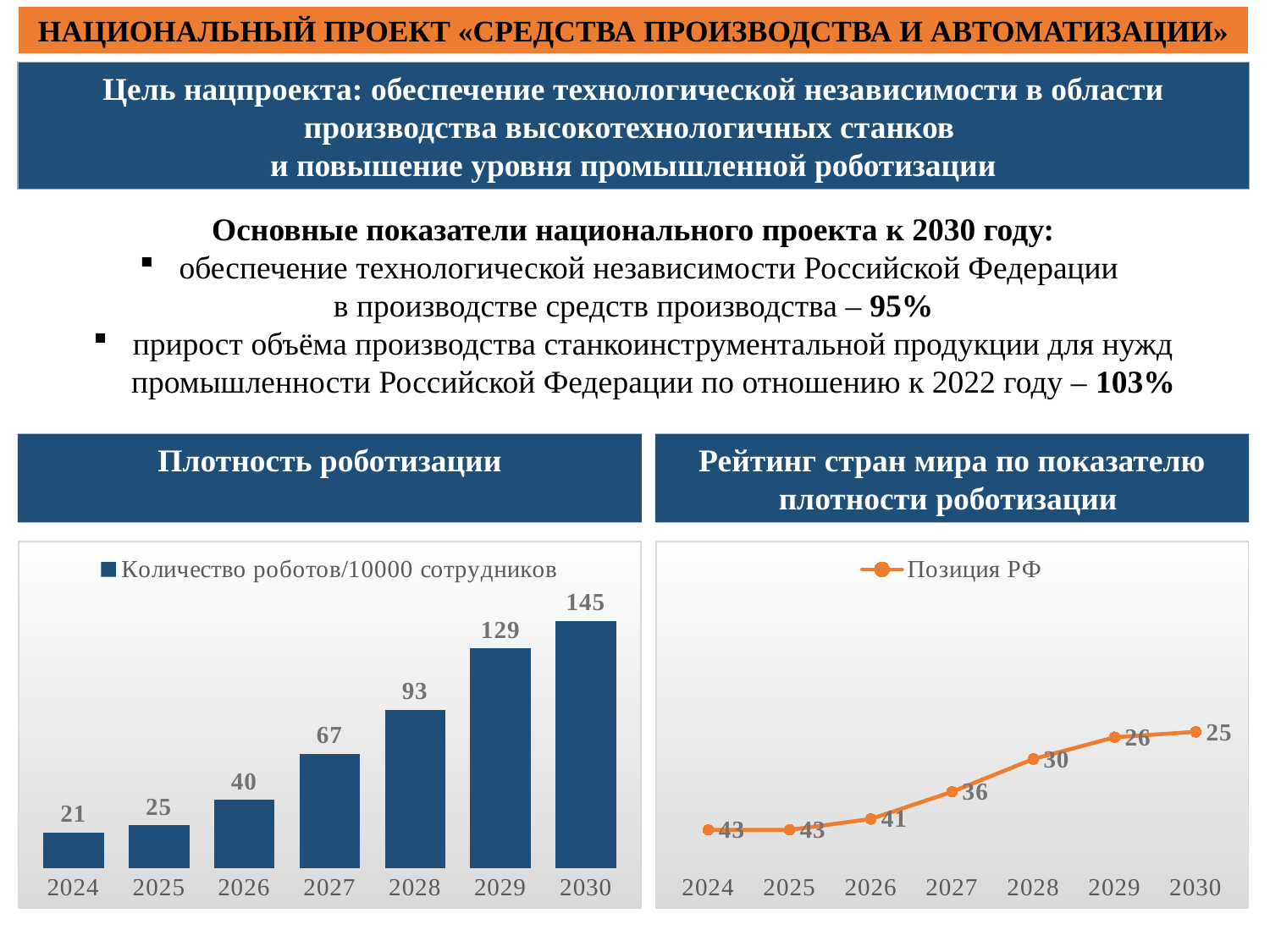
In the 'Рейтинг стран мира по показателю плотности роботизации' chart, what is the value for 2028? 30 In the 'Плотность роботизации' chart, do the values rise or fall from 2024 to 2030? rise In the 'Плотность роботизации' chart, which year has the lowest value? 2024 In the 'Рейтинг стран мира по показателю плотности роботизации' chart, is the value for 2027 larger or smaller than the value for 2029? larger What kind of chart is the 'Рейтинг стран мира по показателю плотности роботизации' chart? line chart What kind of chart is the 'Плотность роботизации' chart? bar chart What is the legend entry of the 'Рейтинг стран мира по показателю плотности роботизации' chart? Позиция РФ In the 'Плотность роботизации' chart, what is the difference between the values for 2030 and 2024? 124 In the 'Плотность роботизации' chart, what is the value for 2027? 67 In the 'Рейтинг стран мира по показателю плотности роботизации' chart, what is the value for 2030? 25 In the 'Плотность роботизации' chart, which year has the highest value? 2030 In the 'Плотность роботизации' chart, how many years are shown on the x axis? 7